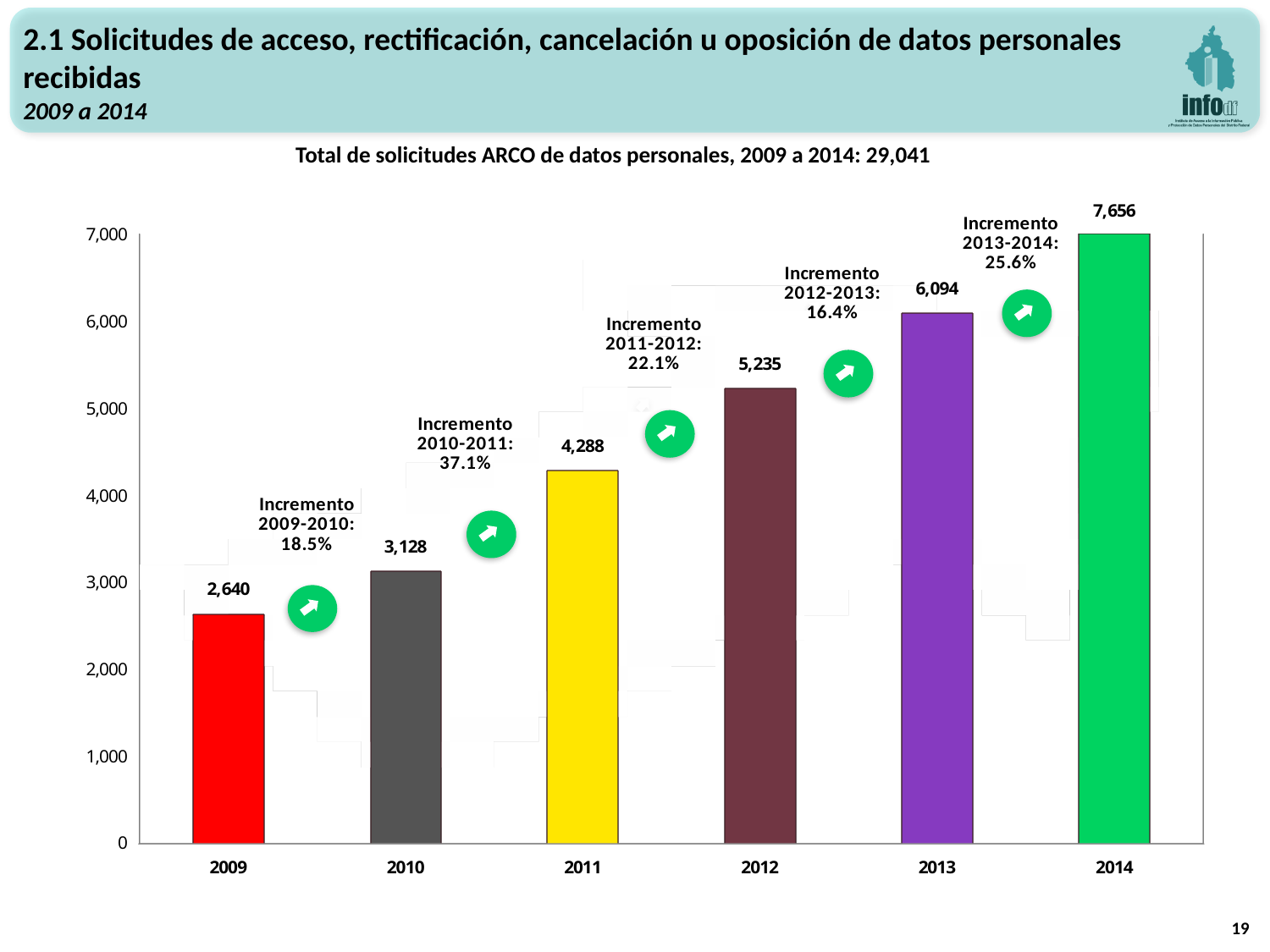
What is the value for 2011? 4,288 Do the values rise or fall from 2009 to 2014? rise What is the difference between the values for 2010 and 2009? 488 Is the value for 2012 greater or less than 5,000? greater What kind of chart is shown on the slide? bar chart Which year has the highest value? 2014 How many years are shown on the x axis? 6 What is the difference between the values for 2014 and 2013? 1,562 Which is larger, the value for 2012 or the value for 2011? 2012 What percentage increase is shown for 2010-2011? 37.1% What is the value for 2013? 6,094 Which year has the lowest value? 2009